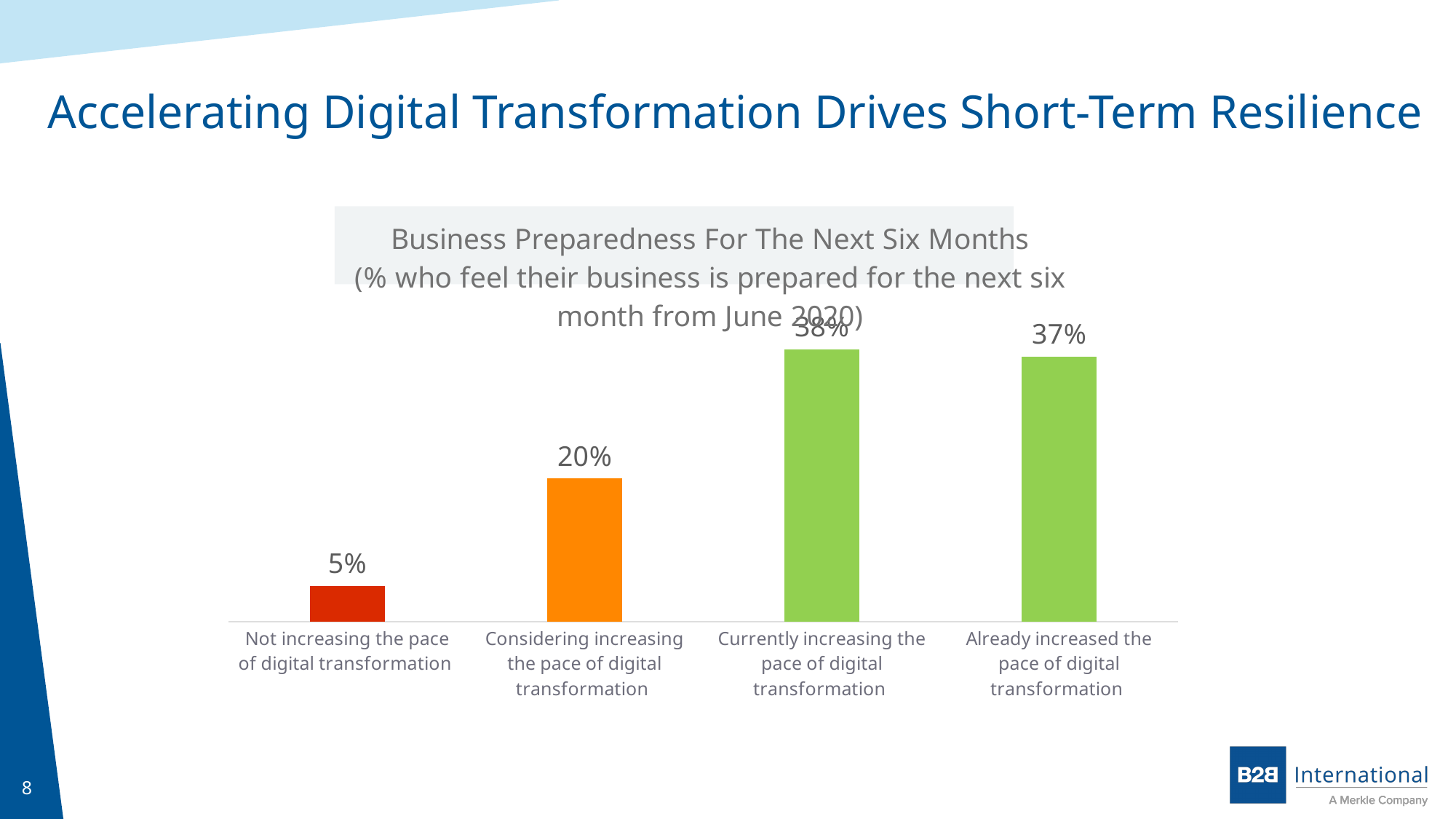
Which category has the lowest percentage feeling prepared for the next six months? Not increasing the pace of digital transformation What colour is the bar for 'Not increasing the pace of digital transformation'? Red What is the difference between the values for 'Currently increasing the pace of digital transformation' and 'Not increasing the pace of digital transformation'? 33% What is the difference between the values for 'Considering increasing the pace of digital transformation' and 'Not increasing the pace of digital transformation'? 15% Which category has the highest percentage feeling prepared for the next six months? Currently increasing the pace of digital transformation What is the value for businesses that have already increased the pace of digital transformation? 37% Which is larger: the value for 'Already increased the pace of digital transformation' or 'Considering increasing the pace of digital transformation'? Already increased the pace of digital transformation What type of chart is shown on the slide? Bar chart What is the value for businesses considering increasing the pace of digital transformation? 20% What is the value for businesses currently increasing the pace of digital transformation? 38% How many categories are shown in the chart? 4 What percentage of businesses not increasing the pace of digital transformation feel prepared for the next six months? 5%